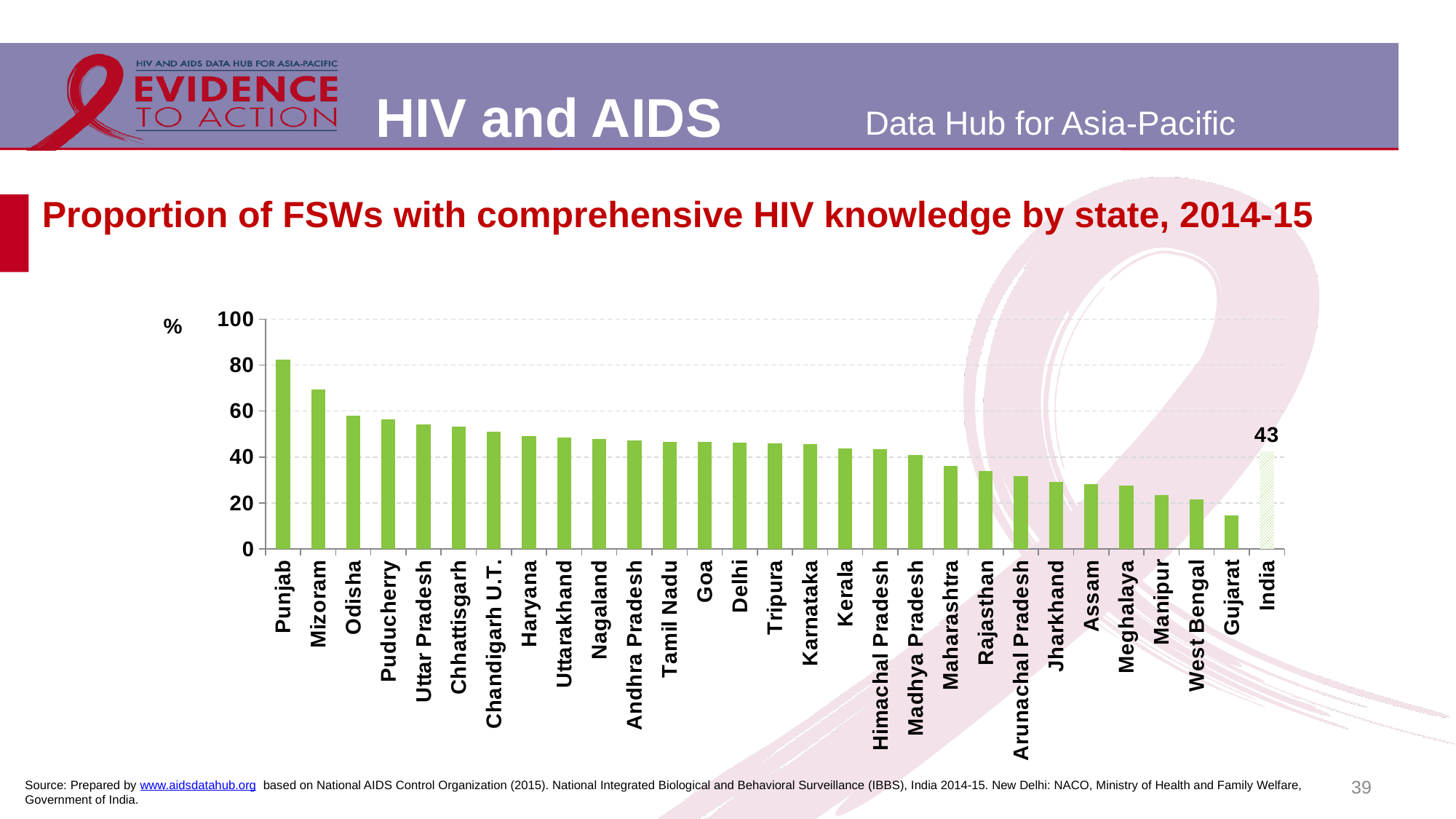
Which has a higher value, Kerala or West Bengal? Kerala Is the value for Gujarat greater or less than 20? less Is the value for Punjab greater or less than 60? greater Is the value for Mizoram greater or less than 60? greater Which state has the lowest proportion of FSWs with comprehensive HIV knowledge? Gujarat How many bars are plotted on the chart, including India? 29 Which state has the highest proportion of FSWs with comprehensive HIV knowledge? Punjab What kind of chart is shown on the slide? bar chart Which has a higher value, Punjab or Mizoram? Punjab Do the state values rise or fall from left to right across the chart (excluding the India bar)? fall What is the value shown for India? 43